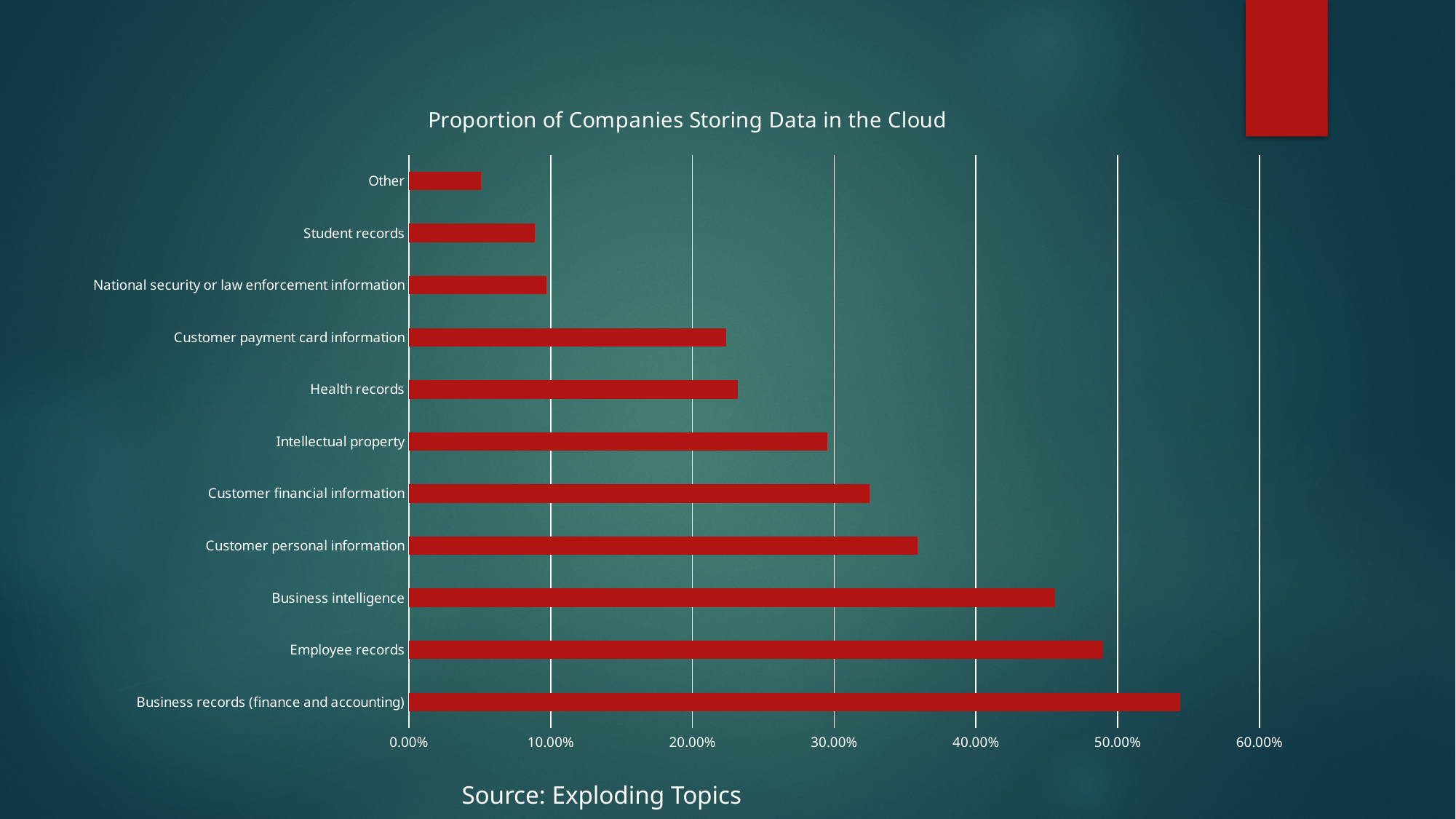
How many categories are plotted in the chart? 11 Which is larger, the value for Employee records or the value for Business intelligence? Employee records Which category has the highest proportion of companies storing data in the cloud? Business records (finance and accounting) What kind of chart is shown on the slide? bar chart Is the value for Business intelligence greater or less than 40.00%? greater What is the title of the chart? Proportion of Companies Storing Data in the Cloud Is the value for Business records (finance and accounting) greater or less than 50.00%? greater Is the value for Other greater or less than 10.00%? less Which category has the lowest proportion of companies storing data in the cloud? Other Which is larger, the value for Customer financial information or the value for Intellectual property? Customer financial information